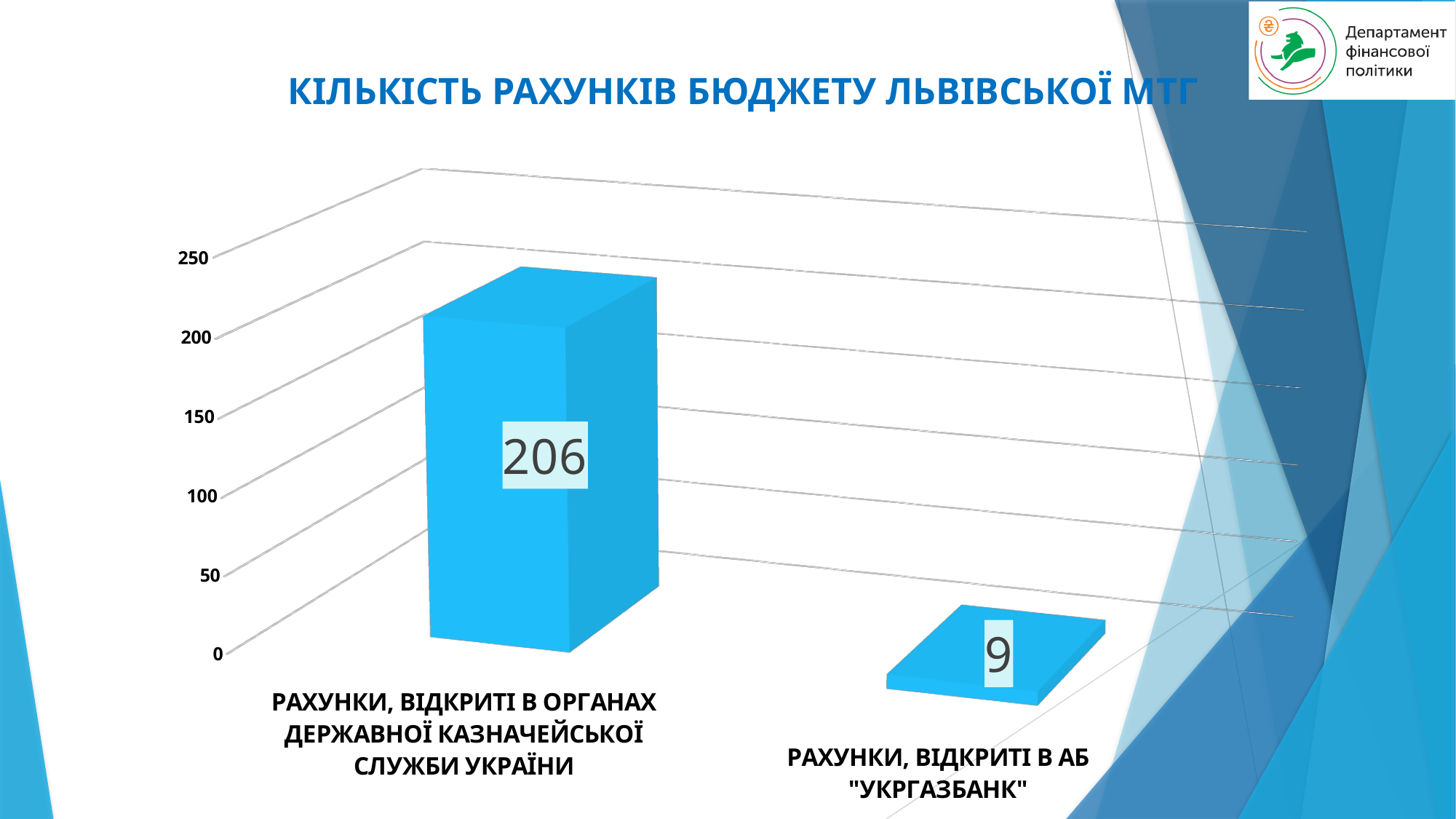
What is the title of the chart? КІЛЬКІСТЬ РАХУНКІВ БЮДЖЕТУ ЛЬВІВСЬКОЇ МТГ Which is larger: the value for accounts in the State Treasury Service or the value for accounts in AB "УКРГАЗБАНК"? РАХУНКИ, ВІДКРИТІ В ОРГАНАХ ДЕРЖАВНОЇ КАЗНАЧЕЙСЬКОЇ СЛУЖБИ УКРАЇНИ What is the value for accounts opened in AB "УКРГАЗБАНК"? 9 How many categories are shown in the chart? 2 Is the value for accounts in the State Treasury Service greater or less than 200? greater What is the maximum value shown on the vertical axis? 250 What is the value for accounts opened in the State Treasury Service of Ukraine (РАХУНКИ, ВІДКРИТІ В ОРГАНАХ ДЕРЖАВНОЇ КАЗНАЧЕЙСЬКОЇ СЛУЖБИ УКРАЇНИ)? 206 What is the difference between the number of accounts in the State Treasury Service and the number in AB "УКРГАЗБАНК"? 197 Is the value for accounts in AB "УКРГАЗБАНК" greater or less than 50? less What kind of chart is shown on the slide? bar chart Which category has the lowest value? РАХУНКИ, ВІДКРИТІ В АБ "УКРГАЗБАНК" Which category has the highest value? РАХУНКИ, ВІДКРИТІ В ОРГАНАХ ДЕРЖАВНОЇ КАЗНАЧЕЙСЬКОЇ СЛУЖБИ УКРАЇНИ